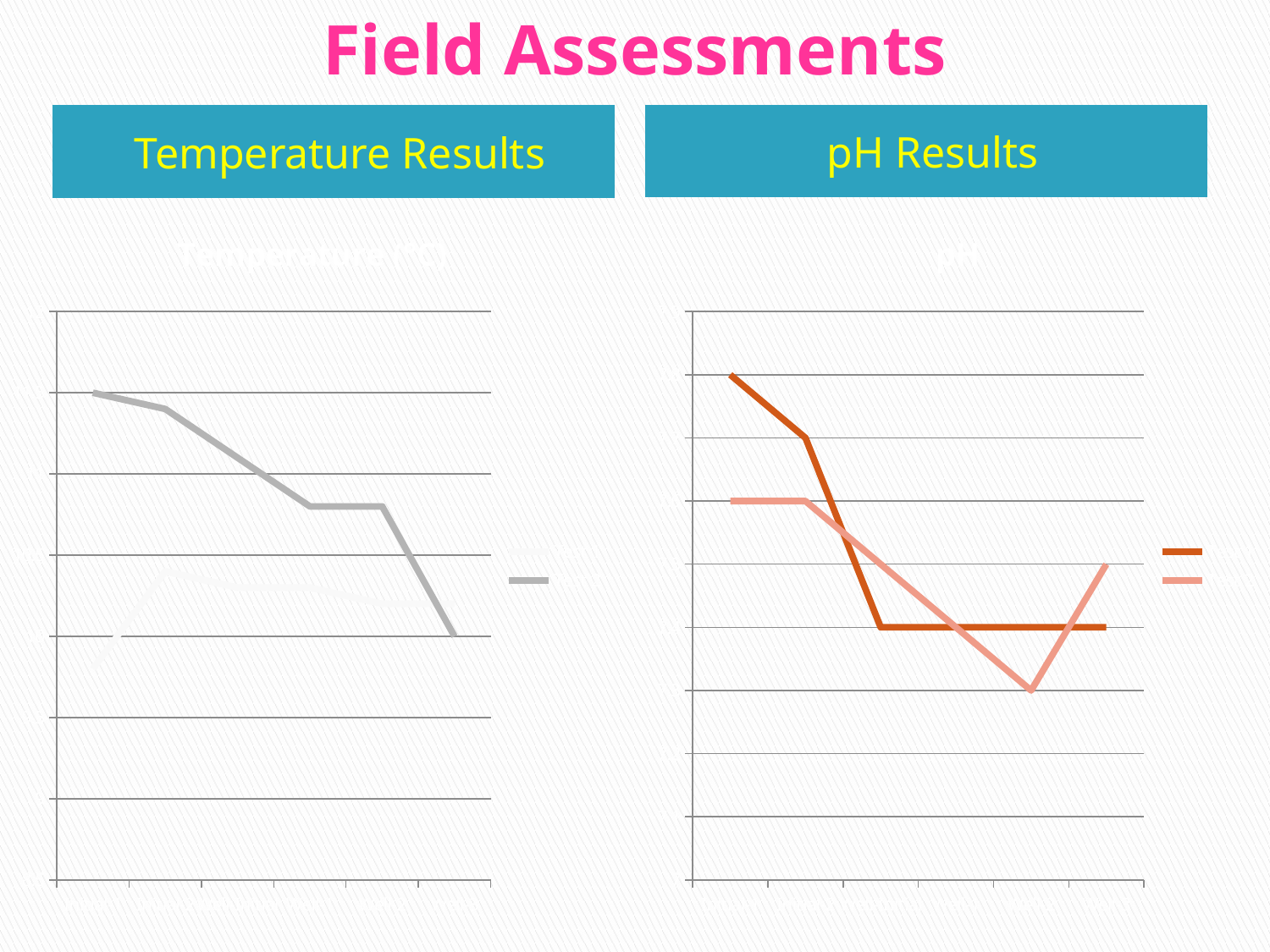
What kind of chart is the pH Results chart on the right? line chart In the Temperature Results chart, does the gray line rise or fall from left to right? fall In the pH Results chart, does the dark orange line rise or fall overall from left to right? fall What kind of chart is the Temperature Results chart on the left? line chart How many series does the legend of the pH Results chart list? 2 What is the title of the chart on the right? pH In the pH Results chart, how many data points does the dark orange line have? 6 How many series does the legend of the Temperature Results chart list? 2 In the pH Results chart, at the leftmost point, which line is higher: the dark orange line or the light orange line? dark orange line What is the title of the chart on the left? Temperature (°C) In the pH Results chart, at the rightmost point, which line is higher: the dark orange line or the light orange line? light orange line In the Temperature Results chart, how many data points does the gray line have? 6